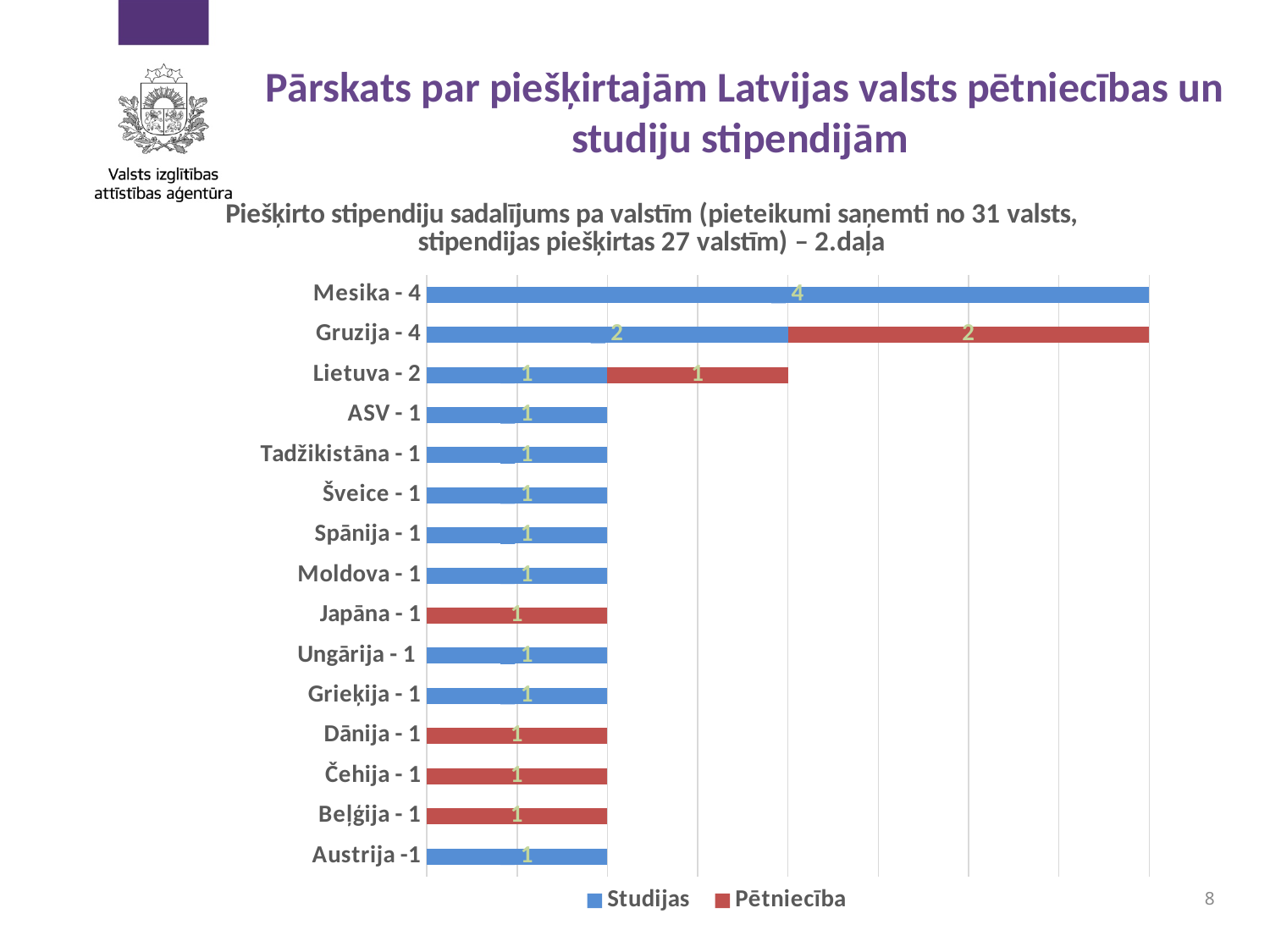
What is the total of the stacked bar for Lietuva - 2? 2 What is the Pētniecība value for Gruzija - 4? 2 What is the total of the stacked bar for Gruzija - 4? 4 What is the Studijas value for Lietuva - 2? 1 What are the two series named in the legend? Studijas and Pētniecība Which series does the bar for Japāna - 1 belong to? Pētniecība Which is larger, the Studijas value for Mesika - 4 or the Studijas value for ASV - 1? Mesika - 4 What is the difference between the Studijas value for Mesika - 4 and the Studijas value for Gruzija - 4? 2 What is the Studijas value for Mesika - 4? 4 How many series does the legend list? 2 How many countries (categories) are shown on the chart? 15 What kind of chart is shown on the slide? bar chart